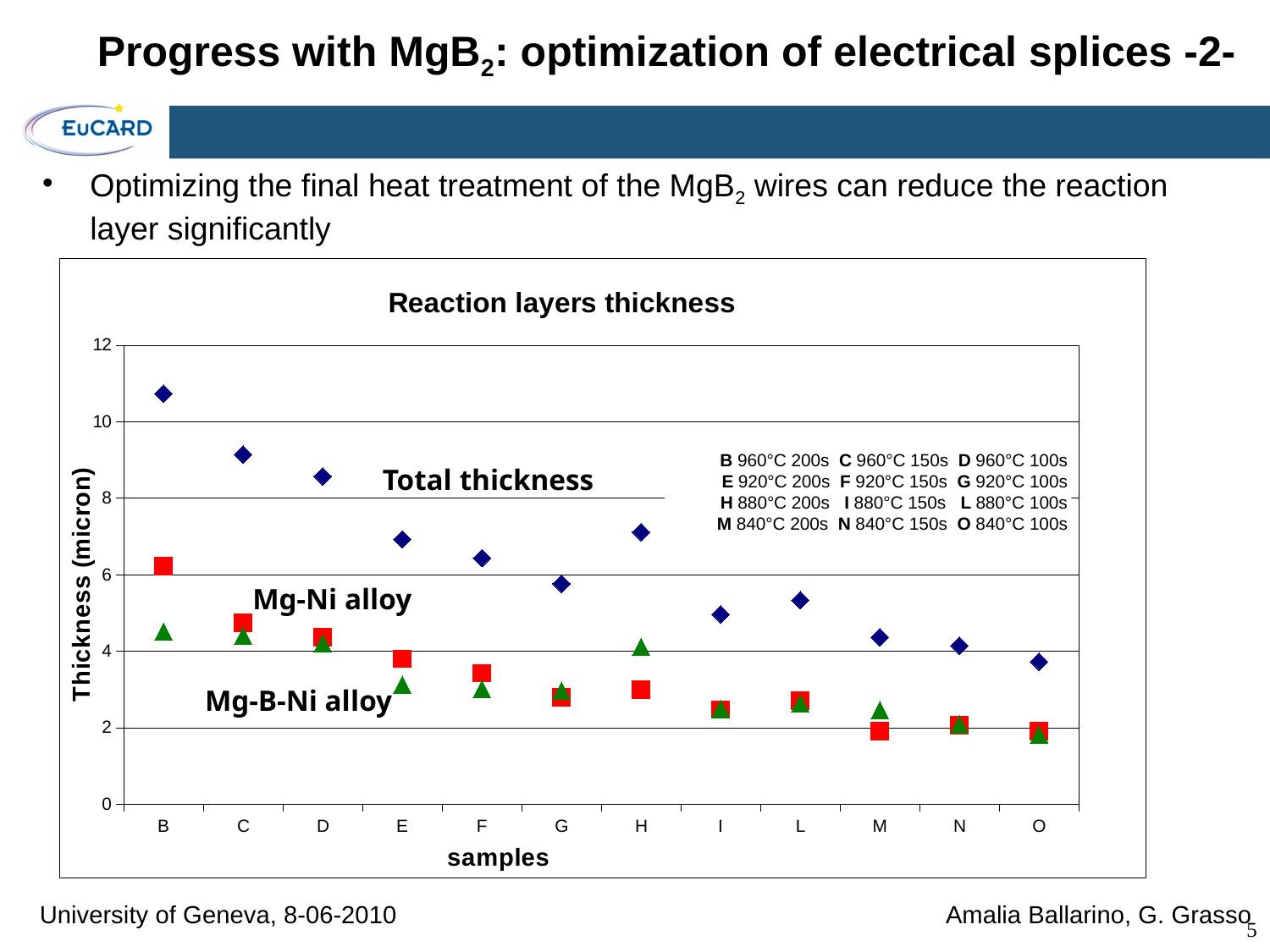
How many data series are labelled on the chart? 3 What is the title of the chart? Reaction layers thickness What kind of chart is shown on the slide? scatter chart Is the Mg-Ni alloy thickness for sample F greater or less than 4? less How many samples are plotted along the x axis? 12 Is the Total thickness for sample B greater or less than 10? greater Does the Total thickness generally rise or fall from sample B to sample O? fall What is the label of the y axis of the chart? Thickness (micron) Is the Total thickness for sample O greater or less than 4? less Which is larger for sample B, the Mg-Ni alloy thickness or the Mg-B-Ni alloy thickness? Mg-Ni alloy Which sample has the highest Total thickness? B Which sample has the lowest Total thickness? O